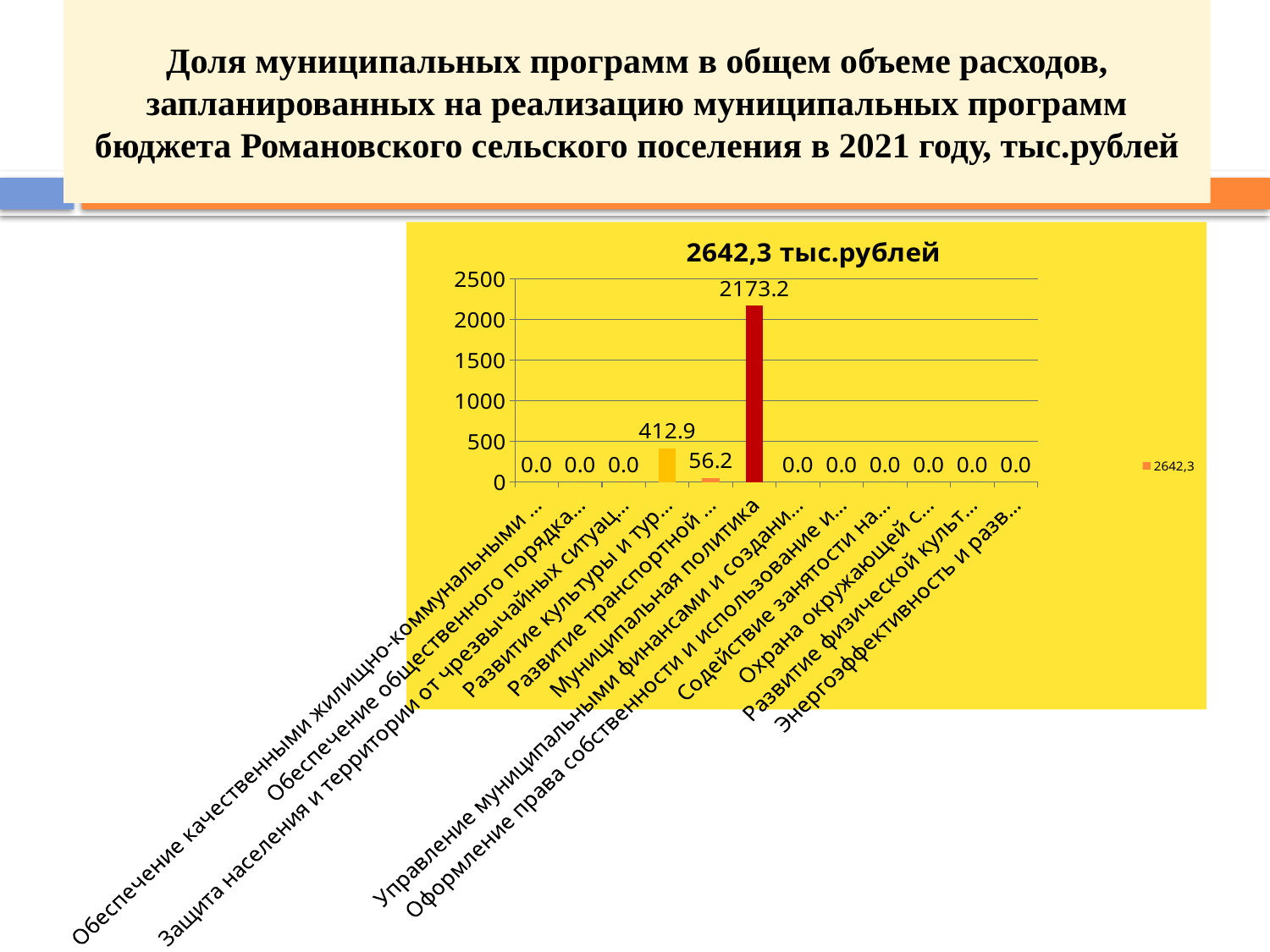
What kind of chart is shown? bar chart Which is larger: the value for the category beginning "Развитие культуры" or the value for the category beginning "Развитие транспортной"? Развитие культуры Is the value for Муниципальная политика greater or less than 2000? greater Which category has the highest value? Муниципальная политика How many categories are shown on the x axis? 12 What is the value for Муниципальная политика? 2173.2 What is the difference between the values for the categories beginning "Развитие культуры" and "Развитие транспортной"? 356.7 What is the value for the category whose label begins "Развитие транспортной"? 56.2 What is the difference between the value for Муниципальная политика and the value for the category beginning "Развитие культуры"? 1760.3 What is the value for the category whose label begins "Развитие культуры"? 412.9 What is the title of the chart? 2642,3 тыс.рублей How many series does the legend list? 1